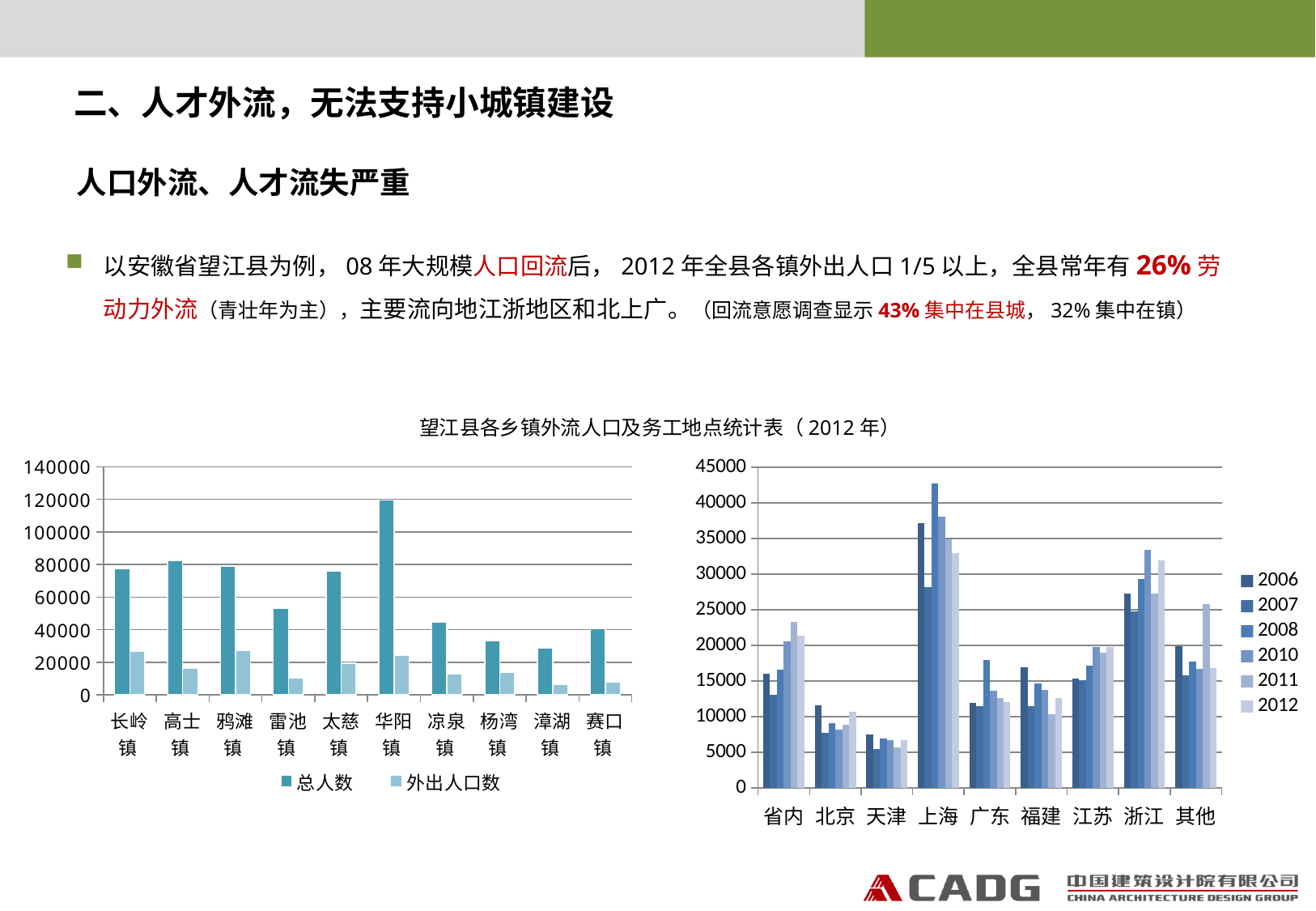
In the left chart, is the 外出人口数 for 雷池镇 greater or less than 20000? less In the left chart, which town has the lowest 总人数? 漳湖镇 In the left chart, which town has the highest 总人数? 华阳镇 In the left chart, is the 总人数 for 华阳镇 greater or less than 100000? greater How many series does the legend of the left chart list? 2 In the left chart, which is larger: the 总人数 for 高士镇 or the 总人数 for 凉泉镇? 高士镇 How many towns are shown on the x axis of the left chart? 10 How many series does the legend of the right chart list? 6 How many destination categories are shown on the x axis of the right chart? 9 In the right chart, is the 2008 value for 上海 greater or less than 40000? greater What kind of chart is the left chart showing 总人数 and 外出人口数? bar chart In the right chart, which is larger: the 2012 value for 省内 or the 2012 value for 北京? 省内